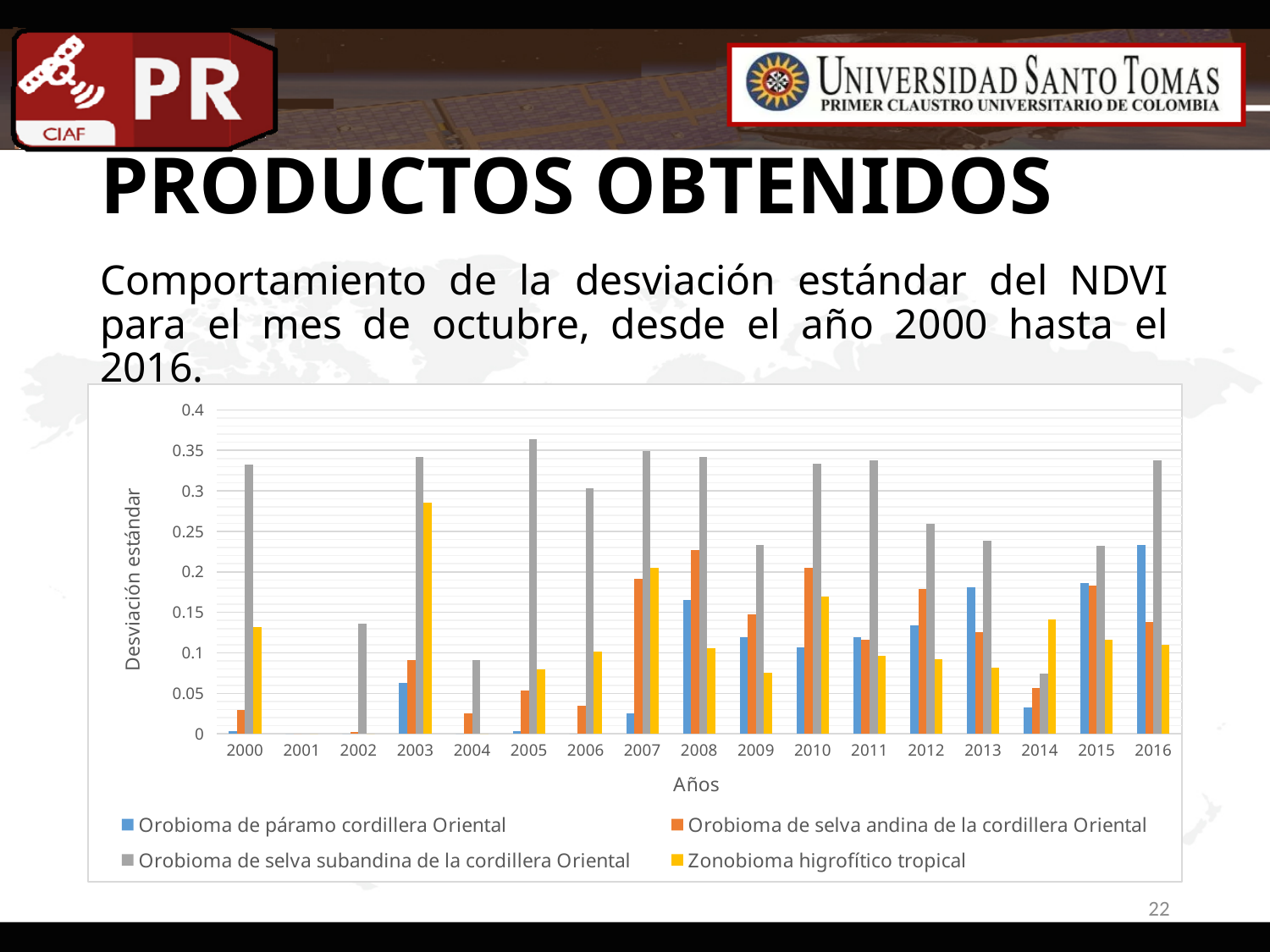
In 2014, which is larger: Zonobioma higrofítico tropical or Orobioma de selva subandina de la cordillera Oriental? Zonobioma higrofítico tropical Which year has the highest value for Orobioma de selva subandina de la cordillera Oriental? 2005 What is the title of the vertical axis? Desviación estándar Which year has the highest value for Orobioma de páramo cordillera Oriental? 2016 Is the value for Orobioma de selva subandina de la cordillera Oriental in 2014 greater or less than 0.1? less Is the value for Orobioma de selva subandina de la cordillera Oriental in 2000 greater or less than 0.3? greater Which year has the highest value for Zonobioma higrofítico tropical? 2003 What kind of chart is shown on the slide? bar chart How many series does the legend list? 4 Is the value for Zonobioma higrofítico tropical in 2003 greater or less than 0.25? greater In 2016, which is larger: Orobioma de páramo cordillera Oriental or Orobioma de selva andina de la cordillera Oriental? Orobioma de páramo cordillera Oriental How many years are shown along the x axis? 17